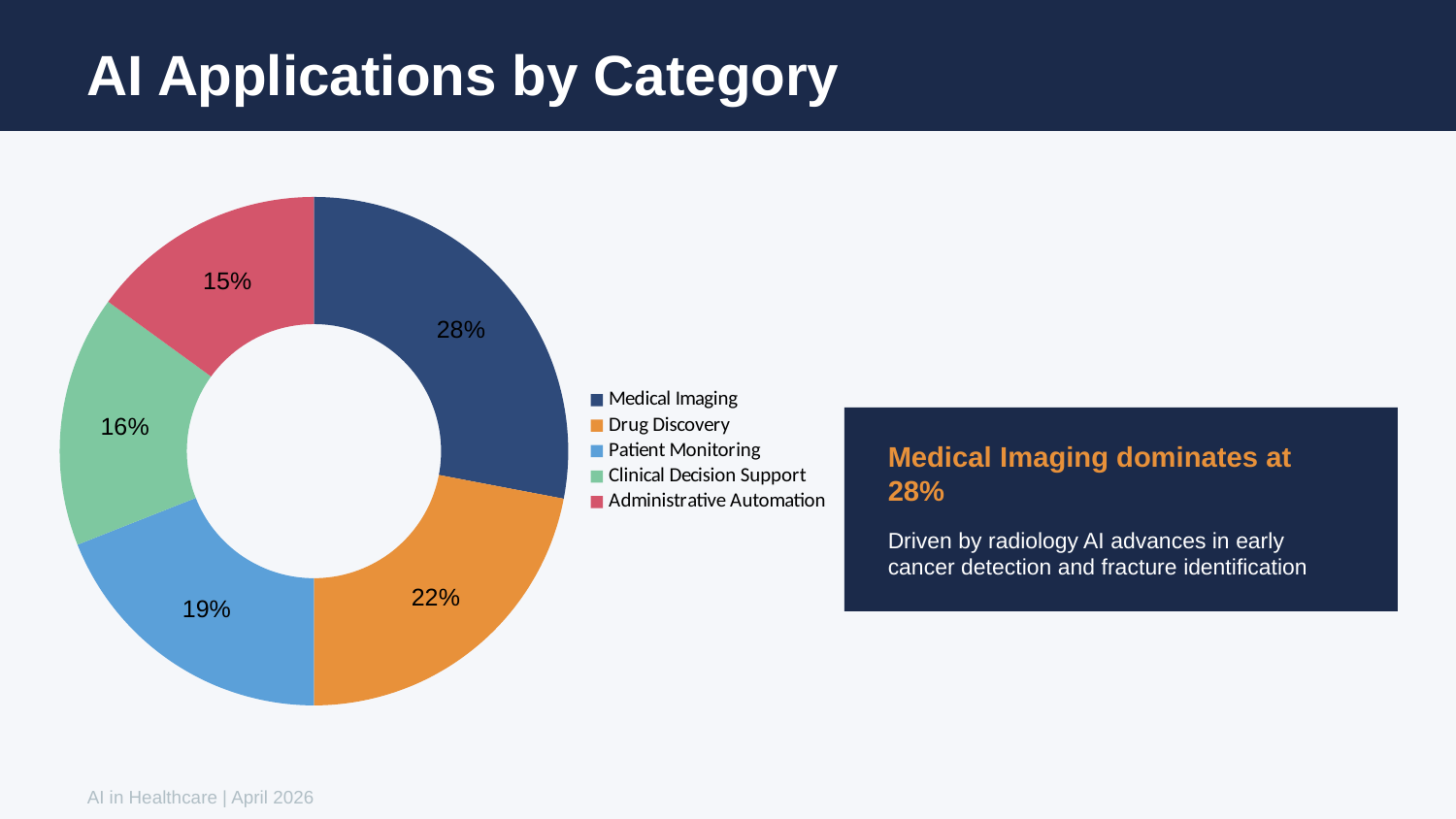
What is the title of the slide? AI Applications by Category Which is larger, Patient Monitoring or Clinical Decision Support? Patient Monitoring What is the difference between the Medical Imaging and Drug Discovery shares? 6% What is the value for Drug Discovery? 22% What is the value for Clinical Decision Support? 16% How many categories are shown in the chart? 5 What is the value for Administrative Automation? 15% Which category has the smallest share? Administrative Automation Which category has the largest share? Medical Imaging What share of the pie does Medical Imaging have? 28% What is the value for Patient Monitoring? 19% What kind of chart is shown on the slide? Doughnut chart